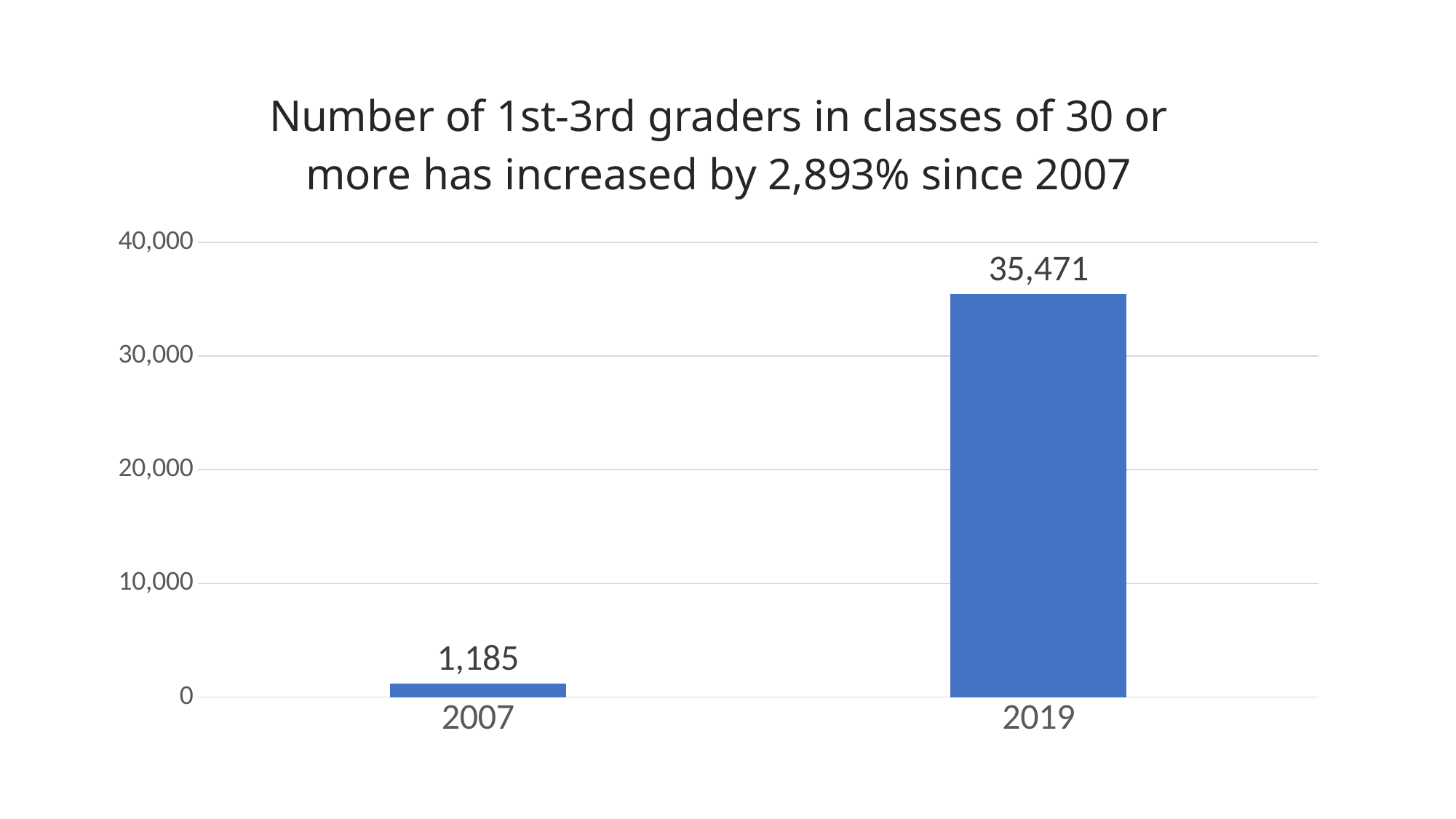
Which year has the highest value? 2019 Is the value for 2019 greater or less than 30,000? greater How many categories are shown on the x axis? 2 What is the difference between the values for 2019 and 2007? 34,286 Which year has the lowest value? 2007 Is the value for 2007 greater or less than 10,000? less What percentage increase since 2007 does the chart title state? 2,893% What kind of chart is shown on the slide? bar chart What is the value for 2019? 35,471 Which is larger, the value for 2007 or the value for 2019? 2019 What is the value for 2007? 1,185 Do the values rise or fall from 2007 to 2019? rise